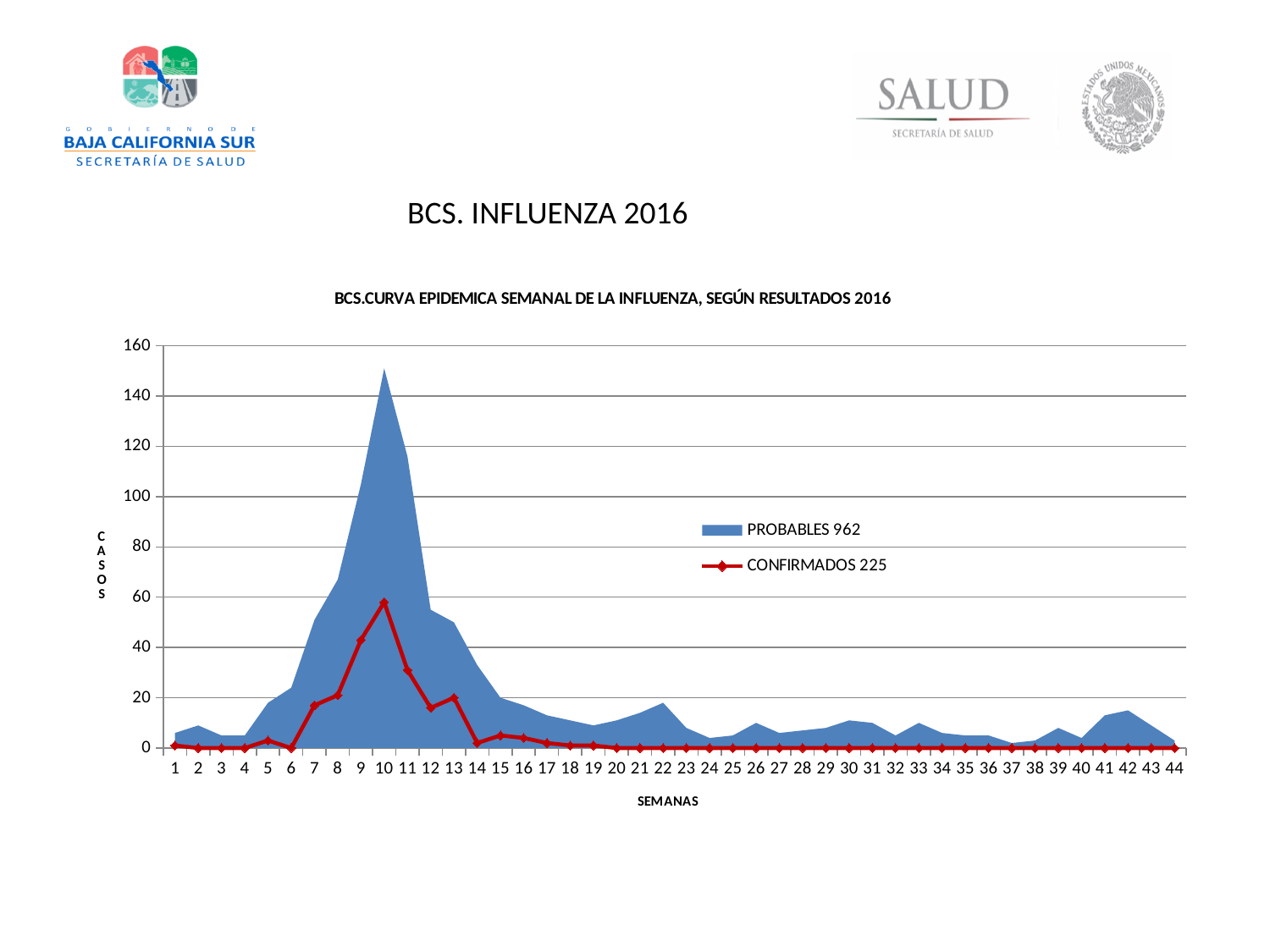
Do the PROBABLES values rise or fall from week 10 to week 20? fall Is the value of PROBABLES in week 22 greater or less than 40? less How many series does the legend list? 2 What is the title of the chart? BCS.CURVA EPIDEMICA SEMANAL DE LA INFLUENZA, SEGÚN RESULTADOS 2016 Is the value of CONFIRMADOS in week 10 greater or less than 40? greater Is the value of PROBABLES in week 10 greater or less than 140? greater Which is larger, the PROBABLES value in week 10 or in week 42? week 10 What label is shown on the x axis of the chart? SEMANAS What are the two legend entries of the chart? PROBABLES 962 and CONFIRMADOS 225 In which week does the PROBABLES series reach its highest value? 10 How many weeks (semanas) are shown on the x axis? 44 In which week does the CONFIRMADOS series reach its highest value? 10